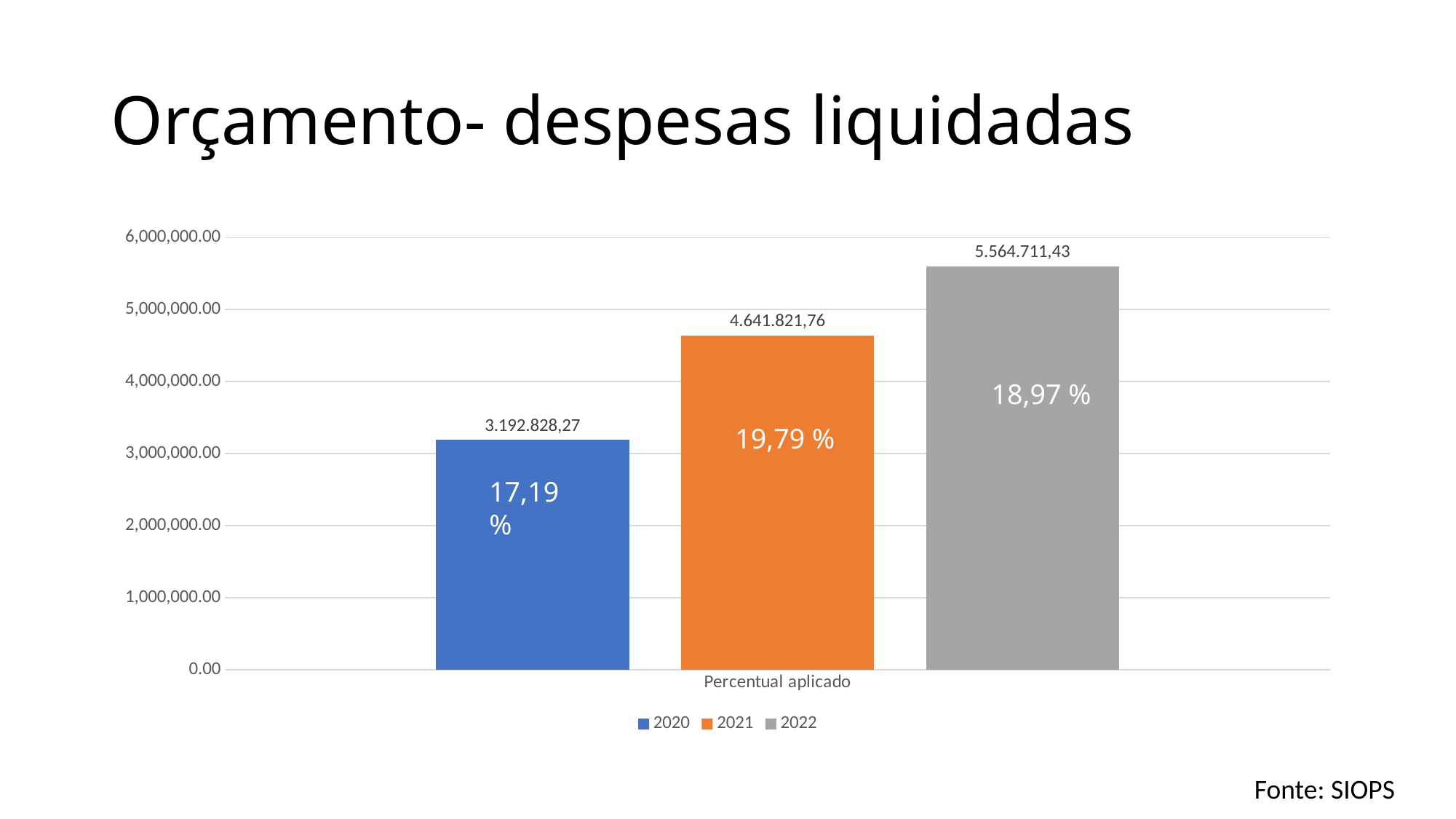
Is the value for 2020 greater or less than 3,000,000.00? greater What is the difference between the 2022 value and the 2021 value? 922.889,67 What kind of chart is shown on the slide? bar chart How many series does the legend list? 3 What is the value shown for the 2021 bar? 4.641.821,76 What is the value shown for the 2022 bar? 5.564.711,43 Which year has the lowest bar? 2020 What percentage is printed inside the 2022 bar? 18,97 % Which year has the highest bar? 2022 What percentage is printed inside the 2021 bar? 19,79 % What percentage is printed inside the 2020 bar? 17,19 % What is the value shown for the 2020 bar? 3.192.828,27